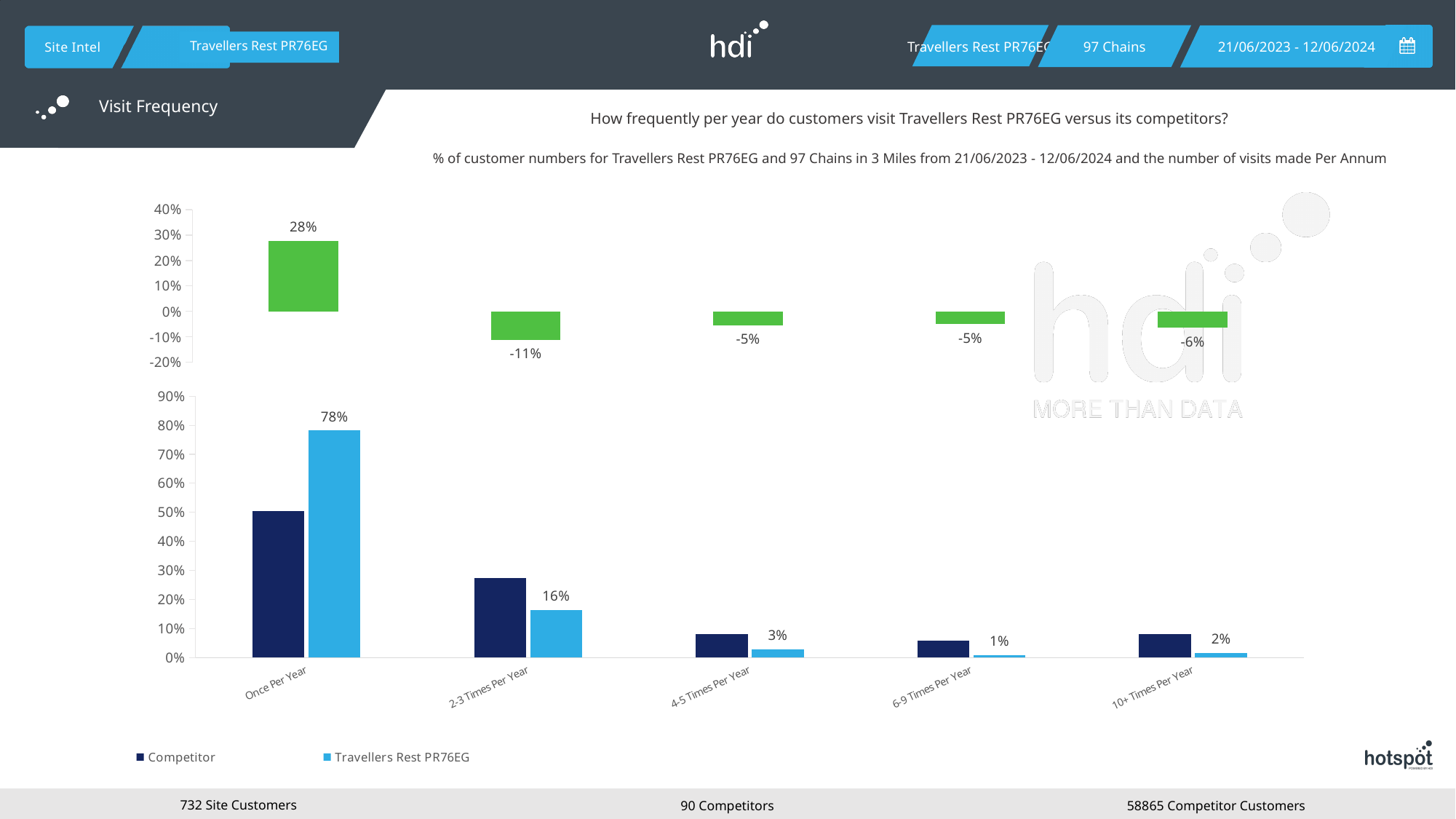
In the top chart (green bars), which category has the highest value? Once Per Year In the bottom chart, what percentage of Travellers Rest PR76EG customers visit Once Per Year? 78% In the bottom chart, is the Competitor value for Once Per Year greater or less than 40%? greater In the top chart (green bars), what is the value for Once Per Year? 28% How many visit-frequency categories are shown on the x axis of the bottom chart? 5 In the top chart (green bars), which category has the lowest value? 2-3 Times Per Year In the bottom chart, for 2-3 Times Per Year, which series has the larger value: Competitor or Travellers Rest PR76EG? Competitor In the top chart (green bars), what is the value for 2-3 Times Per Year? -11% In the bottom chart, what is the difference between the Travellers Rest PR76EG values for Once Per Year and 2-3 Times Per Year? 62 percentage points In the bottom chart, what is the Travellers Rest PR76EG value for 10+ Times Per Year? 2% In the bottom chart, what is the Travellers Rest PR76EG value for 2-3 Times Per Year? 16% How many series does the legend of the bottom chart list? 2